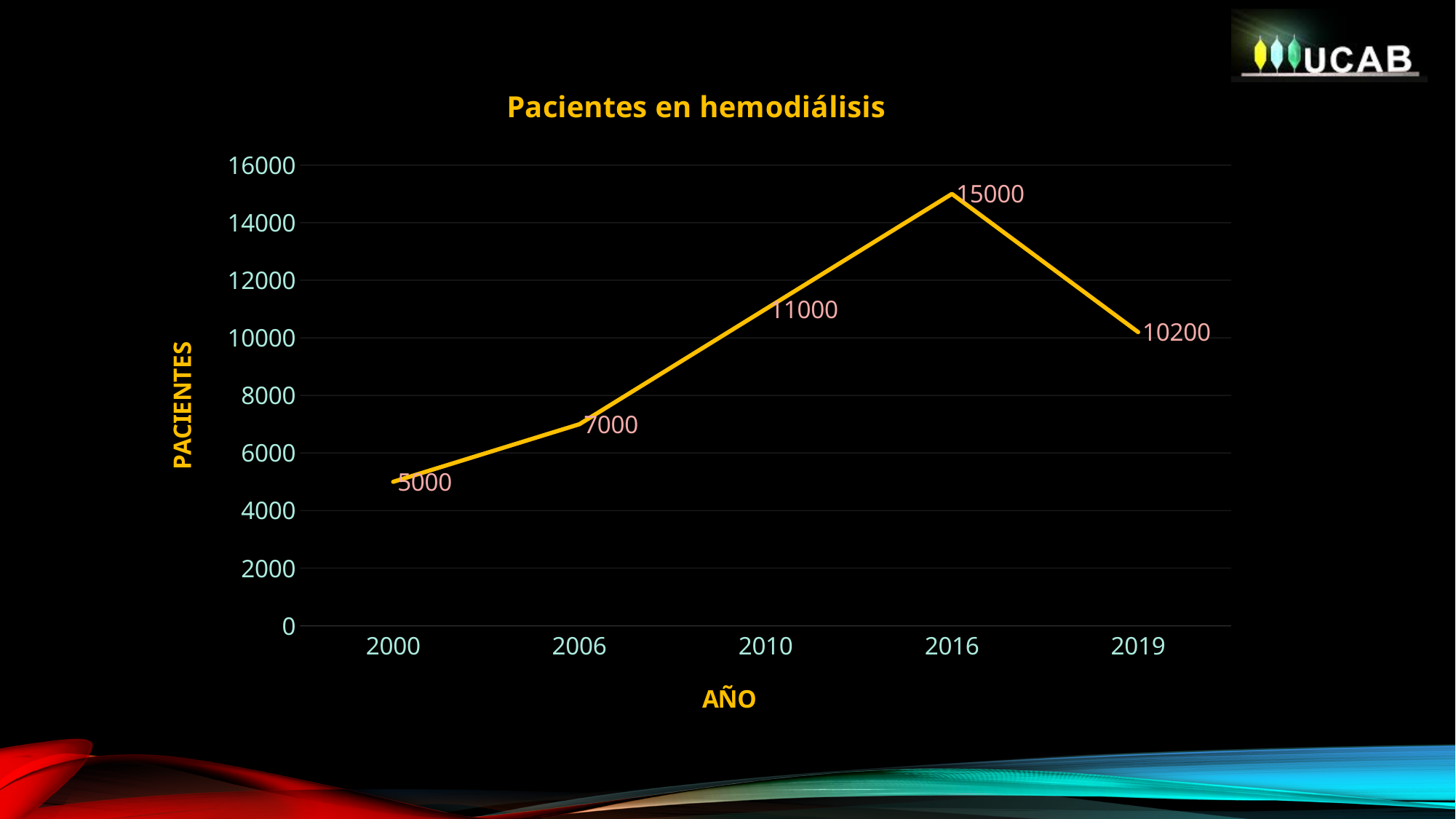
What is the title of the chart? Pacientes en hemodiálisis Which year has the lowest number of patients? 2000 What is the value for 2010? 11000 Do the values rise or fall between 2000 and 2016? Rise What is the difference between the values for 2016 and 2019? 4800 Which year has the highest number of patients? 2016 What is the value for 2000? 5000 What is the value for 2006? 7000 How many years are plotted on the x axis? 5 What kind of chart is this? Line chart Which is larger, the value for 2010 or the value for 2019? 2010 What is the value for 2019? 10200